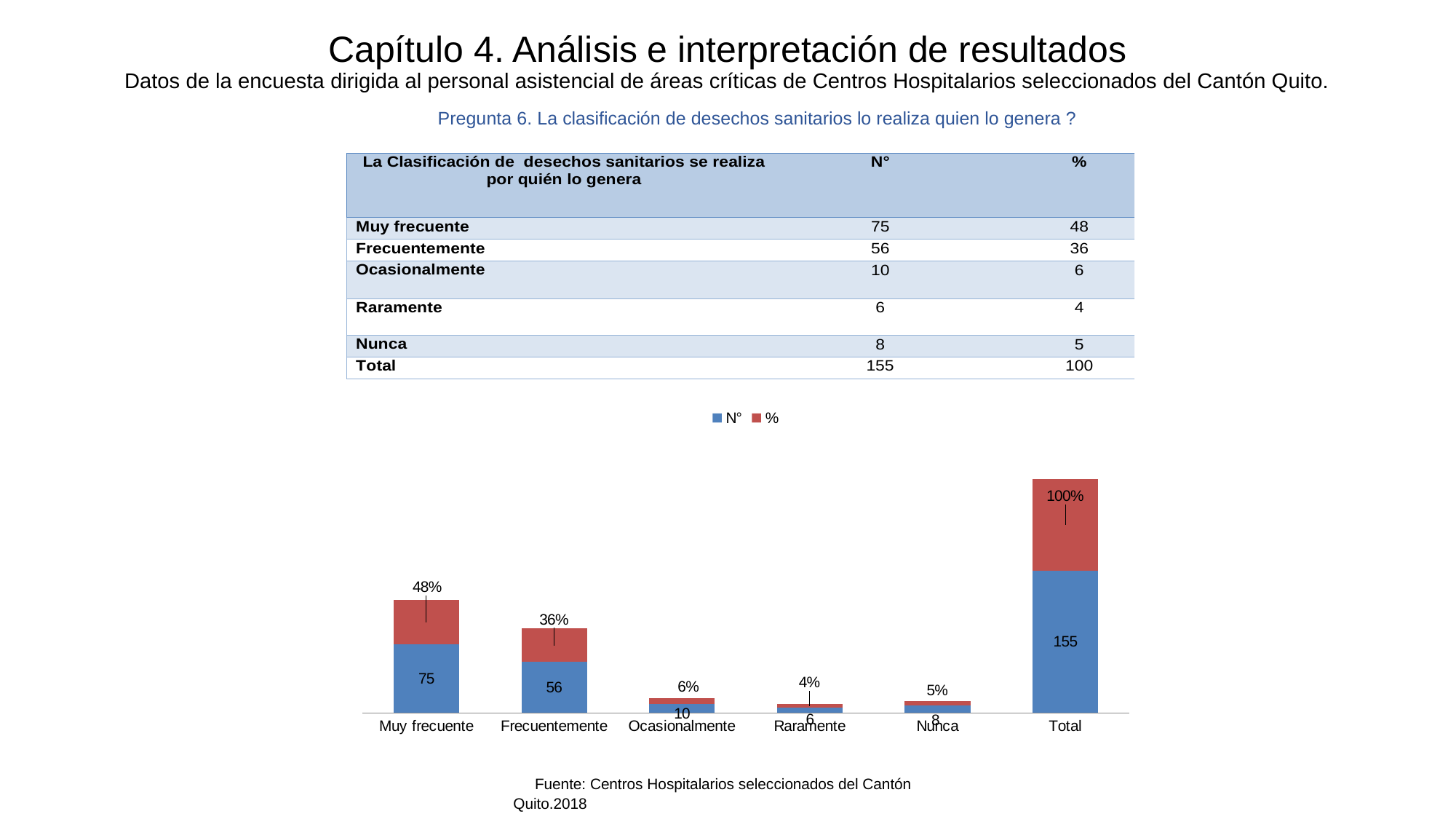
Excluding the Total bar, which category has the highest N° value? Muy frecuente What is the % value shown for Raramente in the chart? 4% How many categories are shown on the x axis of the chart? 6 What is the N° value for Muy frecuente in the chart? 75 Which has a larger N° value, Ocasionalmente or Nunca? Ocasionalmente Excluding the Total bar, which category has the lowest N° value? Raramente What kind of chart is shown on the slide? Stacked bar chart What is the N° value for Nunca in the chart? 8 What is the difference between the N° values for Muy frecuente and Frecuentemente? 19 How many series does the chart legend list? 2 Which colour represents the % series in the chart? Red What is the % value shown for Frecuentemente in the chart? 36%